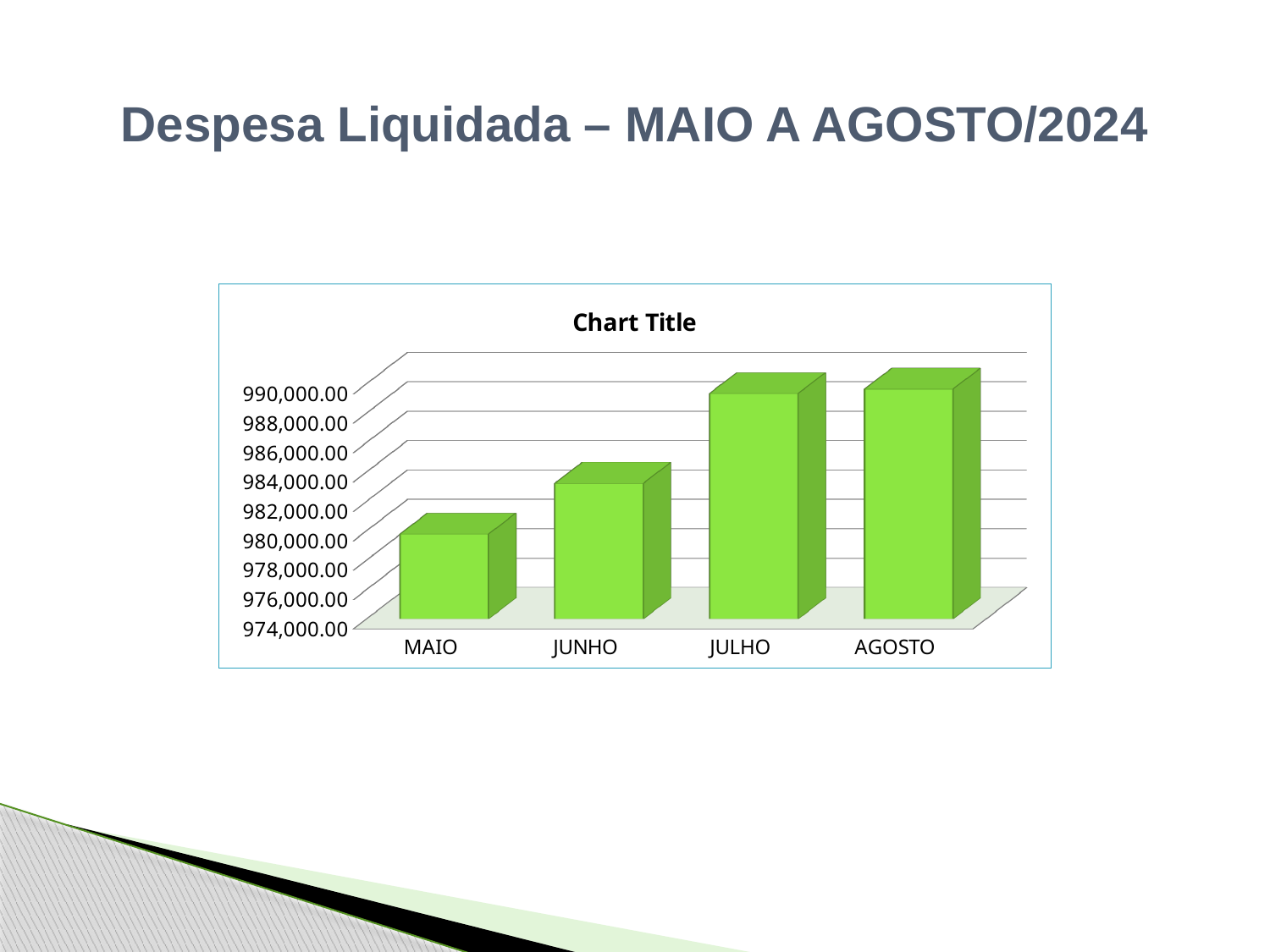
Is the value for JULHO greater or less than 986,000.00? greater Is the value for JUNHO greater or less than 980,000.00? greater Do the values rise or fall from MAIO to AGOSTO along the x axis? rise Which month has the lowest value in the chart? MAIO What colour are the bars in the chart? green What title is printed above the chart's plot area? Chart Title Is the value for MAIO greater or less than 982,000.00? less How many categories are plotted on the x axis of the chart? 4 What kind of chart is shown on the slide? bar chart Which is larger, the value for JUNHO or the value for JULHO? JULHO Which is larger, the value for MAIO or the value for JUNHO? JUNHO